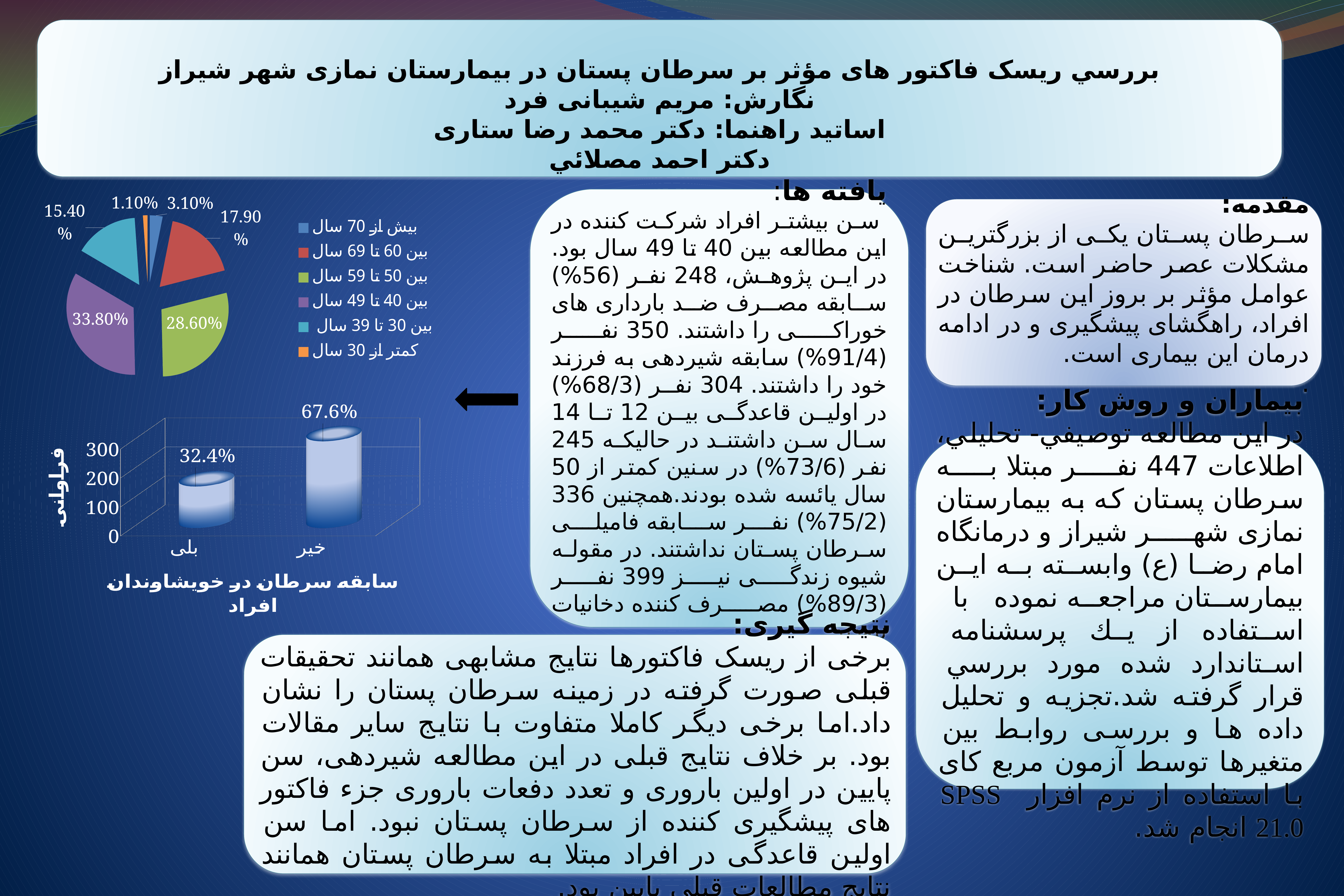
In the top-left pie chart, what share is shown for the 'بین 50 تا 59 سال' slice? 28.60% In the top-left pie chart, which age group has the largest slice? بین 40 تا 49 سال In the top-left pie chart, what is the difference between the 'بین 40 تا 49 سال' and 'بین 50 تا 59 سال' shares? 5.20% In the bottom-left bar chart, which category has the taller bar, 'بلی' or 'خیر'? خیر In the top-left pie chart, what share is shown for the 'بین 40 تا 49 سال' slice? 33.80% In the bottom-left bar chart, what value is labelled on the 'خیر' bar? 67.6% How many entries does the legend of the top-left pie chart list? 6 In the top-left pie chart, what share is shown for the 'بین 60 تا 69 سال' slice? 17.90% In the top-left pie chart, what share is shown for the 'بین 30 تا 39 سال' slice? 15.40% What kind of chart is the bottom-left chart titled 'سابقه سرطان در خویشاوندان افراد'? bar chart In the bottom-left bar chart, what value is labelled on the 'بلی' bar? 32.4% What kind of chart is the top-left chart on the slide? pie chart